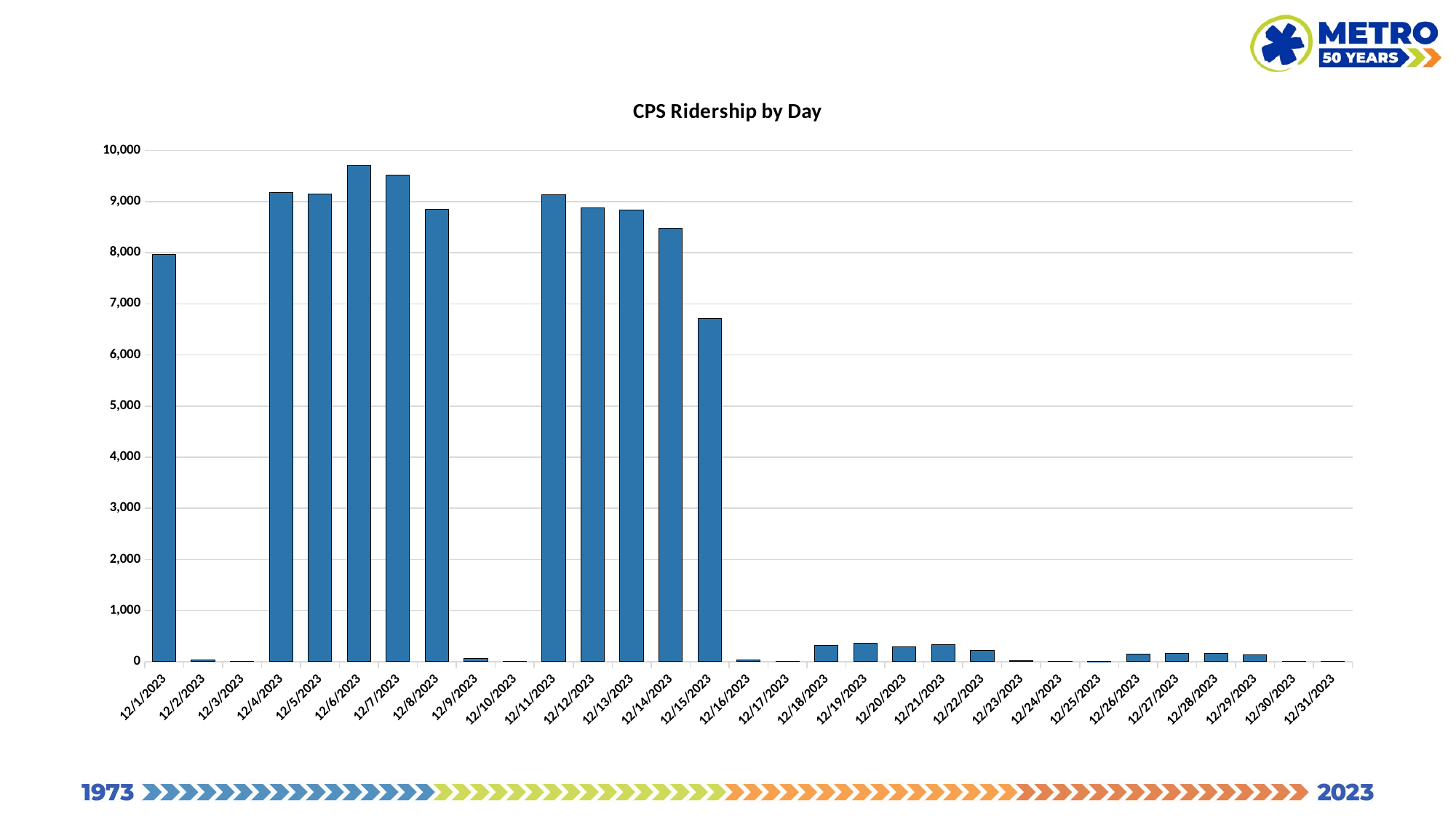
Which has the larger value, 12/6/2023 or 12/7/2023? 12/6/2023 Which has the larger value, 12/11/2023 or 12/15/2023? 12/11/2023 Is the value for 12/6/2023 greater or less than 9,000? greater Is the value for 12/19/2023 greater or less than 1,000? less What is the title of the chart? CPS Ridership by Day Do the values rise or fall from 12/11/2023 to 12/15/2023? fall Is the value for 12/8/2023 greater or less than 9,000? less How many dates are shown on the x axis of the chart? 31 What kind of chart is shown on the slide? bar chart Which date has the highest ridership in the chart? 12/6/2023